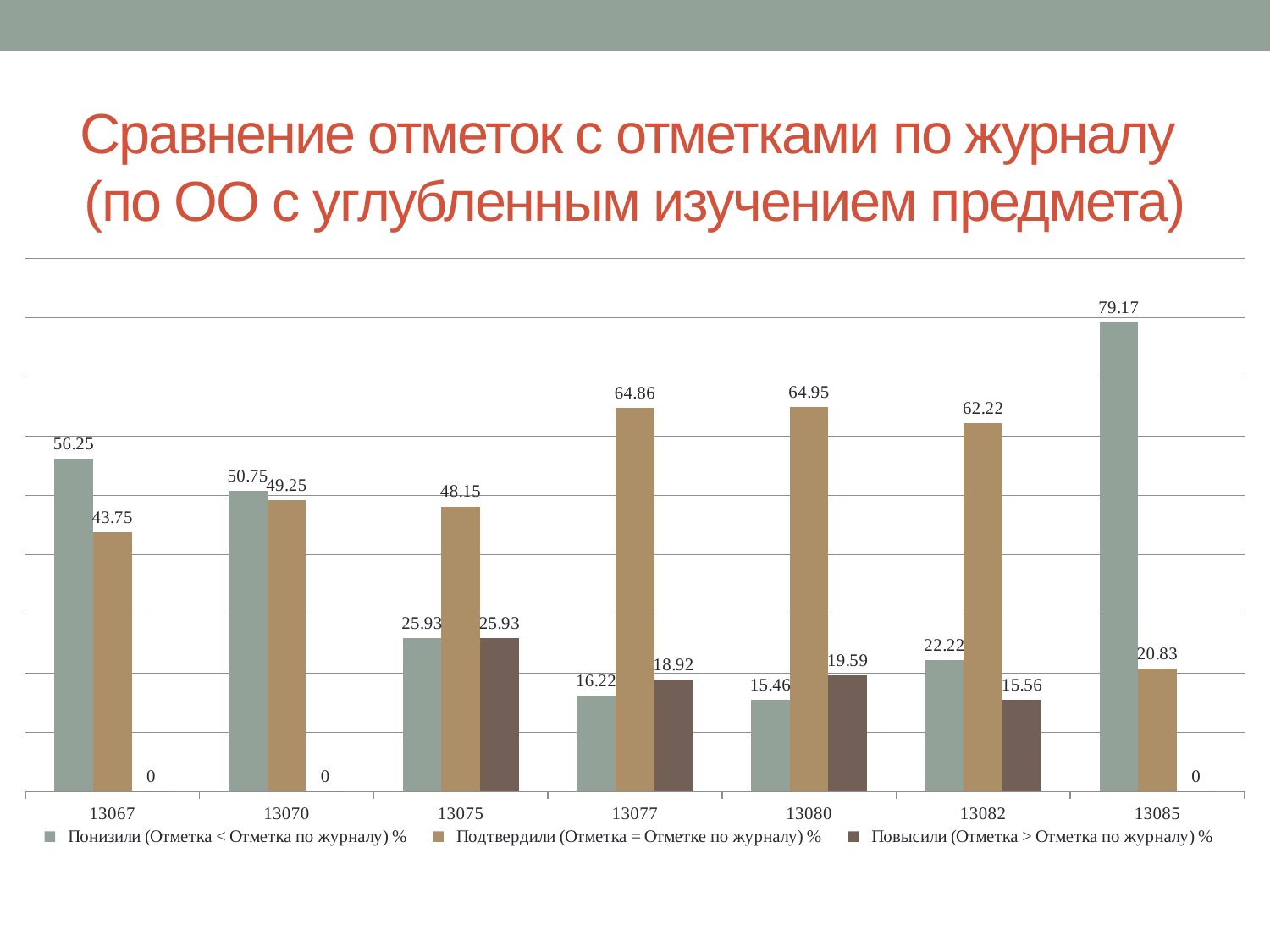
What is the value of the 'Повысили (Отметка > Отметка по журналу) %' series for category 13077? 18.92 Which category has the lowest value for the 'Подтвердили (Отметка = Отметке по журналу) %' series? 13085 What is the value of the 'Подтвердили (Отметка = Отметке по журналу) %' series for category 13080? 64.95 Which category has the highest value for the 'Понизили (Отметка < Отметка по журналу) %' series? 13085 What is the value of the 'Повысили (Отметка > Отметка по журналу) %' series for category 13067? 0 How many series does the legend list? 3 What kind of chart is shown on the slide? Bar chart How many categories are shown on the x axis? 7 What is the value of the 'Понизили (Отметка < Отметка по журналу) %' series for category 13085? 79.17 What is the title of the slide? Сравнение отметок с отметками по журналу (по ОО с углубленным изучением предмета) For category 13082, which is larger: the 'Понизили' value or the 'Повысили' value? Понизили (22.22) What is the difference between the 'Понизили' and 'Подтвердили' values for category 13067? 12.5